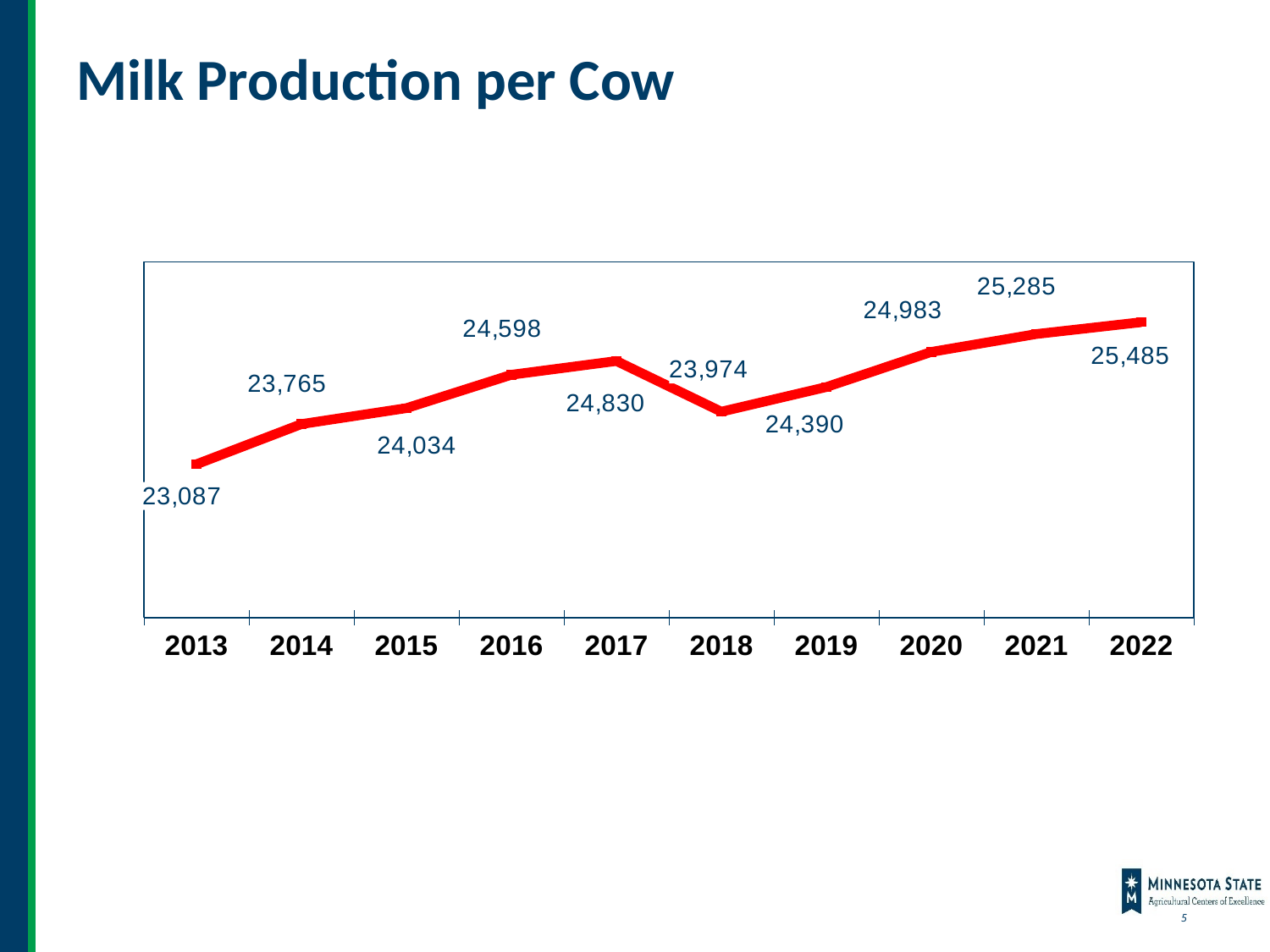
What is the title of the chart? Milk Production per Cow Which year has higher milk production per cow, 2016 or 2019? 2016 What is the milk production per cow in 2013? 23,087 What is the milk production per cow in 2017? 24,830 Which year has the highest milk production per cow? 2022 What is the difference in milk production per cow between 2022 and 2013? 2,398 What is the milk production per cow in 2018? 23,974 How many years are plotted on the chart? 10 Which year has the lowest milk production per cow? 2013 By how much did milk production per cow fall from 2017 to 2018? 856 What type of chart is shown on the slide? line chart What is the milk production per cow in 2022? 25,485